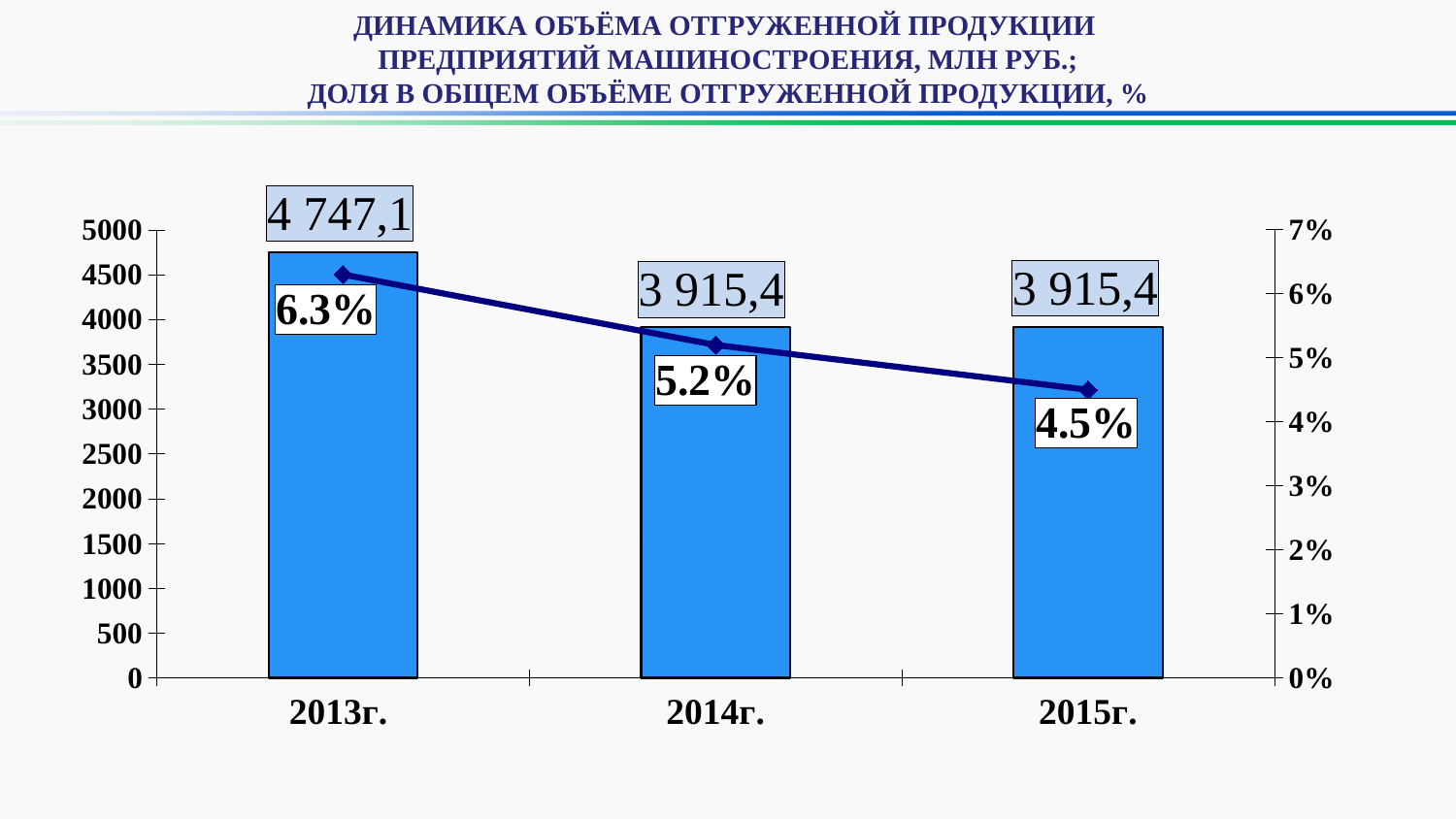
Which year has the lowest share in total shipped products? 2015г. By how many percentage points did the share fall from 2013г. to 2015г.? 1.8% What share of total shipped products (%) is shown for 2013г.? 6.3% What is the difference in shipped product volume between 2013г. and 2014г.? 831,7 Does the share of total shipped products rise or fall from 2013г. to 2015г.? fall What is the volume of shipped products (млн руб.) for 2014г.? 3 915,4 What share of total shipped products (%) is shown for 2015г.? 4.5% What is the volume of shipped products (млн руб.) for 2013г.? 4 747,1 Which year has the highest volume of shipped products? 2013г. Is the share for 2014г. larger or smaller than the share for 2015г.? larger What kind of chart is used to show the volume of shipped products? bar chart How many years are shown on the x axis? 3